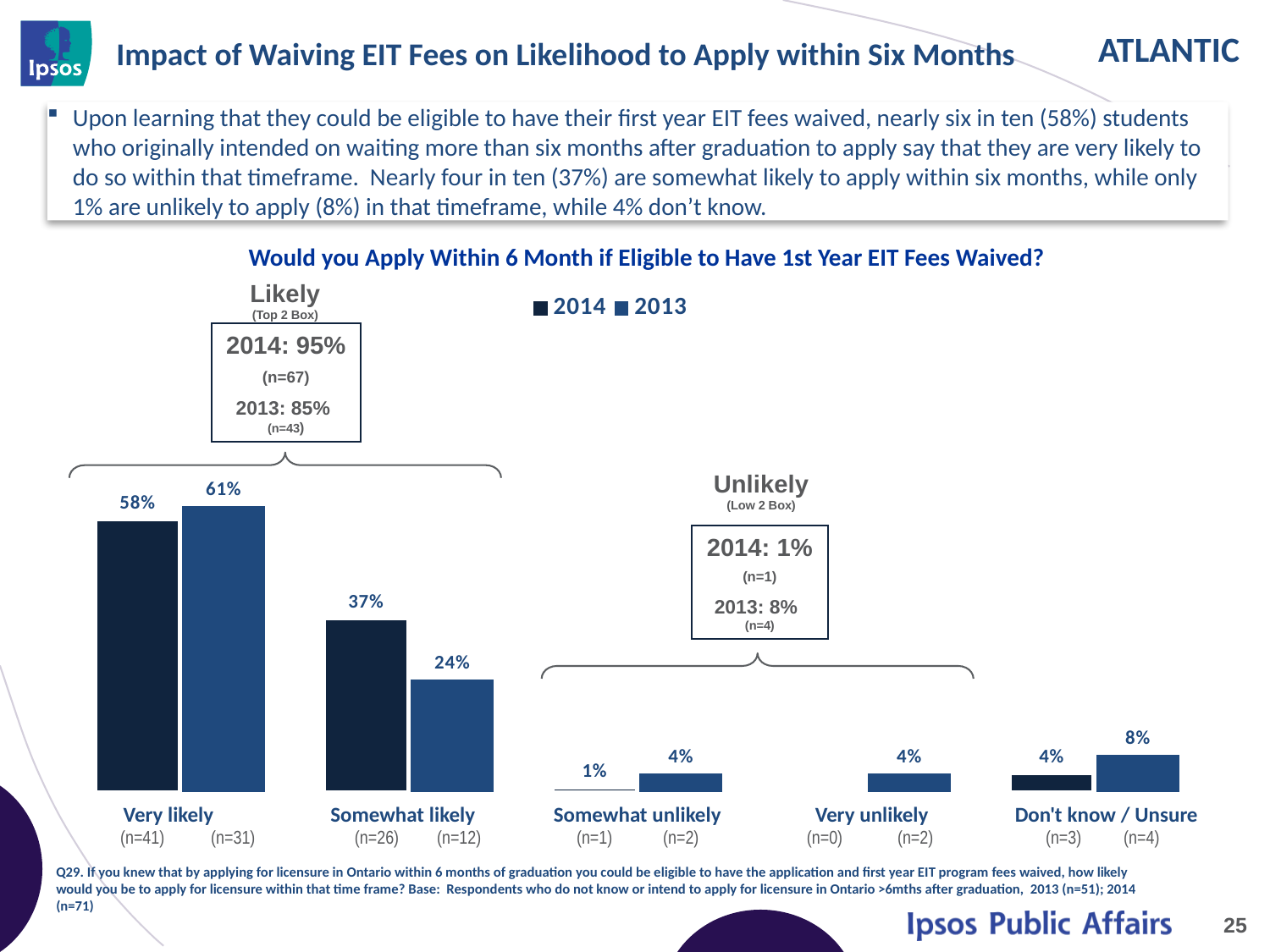
How many response categories are shown on the x axis? 5 What is the 2013 value for Don't know / Unsure? 8% What percentage of 2014 respondents said they are very likely to apply within 6 months? 58% What is the difference between the 2014 and 2013 values for Somewhat likely? 13% For Very likely, which series has the larger value, 2014 or 2013? 2013 For Somewhat likely, which series has the larger value, 2014 or 2013? 2014 How many series does the legend list? 2 What type of chart is shown on the slide? Bar chart What percentage of 2013 respondents said they are somewhat likely to apply within 6 months? 24% What is the difference between the 2013 and 2014 values for Very likely? 3% Which category has the highest value for the 2014 series? Very likely Which category has the lowest value for the 2014 series among those with a labelled bar? Somewhat unlikely